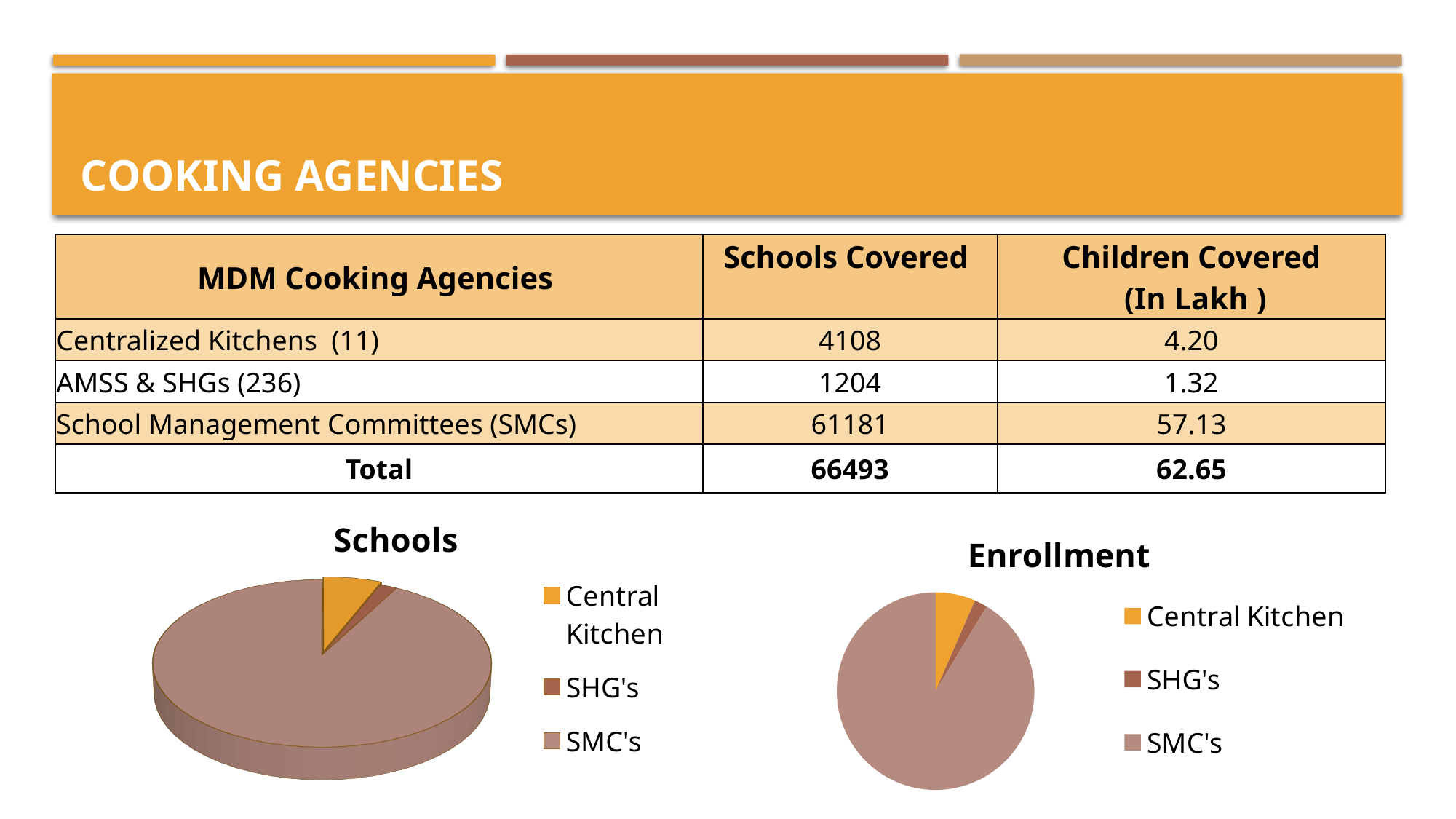
In the "Schools" chart, which slice is larger: Central Kitchen or SHG's? Central Kitchen In the "Schools" chart, what colour is the SHG's slice? Brown How many categories does the "Enrollment" chart legend list? 3 In the "Schools" chart, which category has the smallest slice? SHG's What kind of chart is the "Schools" chart? Pie chart In the "Enrollment" chart, which slice is larger: SMC's or Central Kitchen? SMC's What kind of chart is the "Enrollment" chart? Pie chart In the "Schools" chart, which category has the largest slice? SMC's In the "Enrollment" chart, which category has the smallest slice? SHG's How many categories does the "Schools" chart legend list? 3 What is the title of the pie chart on the right side of the slide? Enrollment In the "Enrollment" chart, which category has the largest slice? SMC's